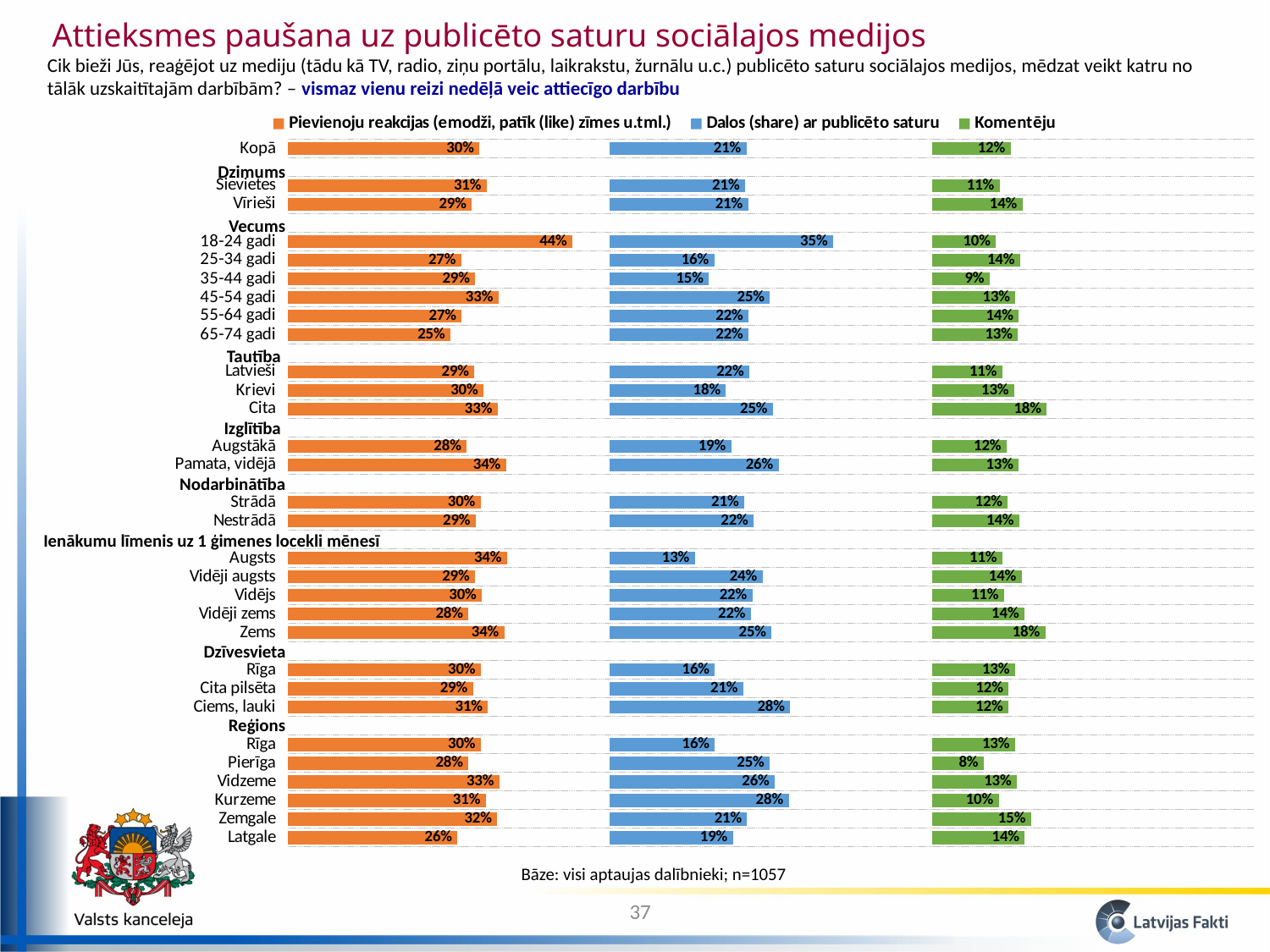
How many series does the legend list? 3 Which category has the lowest value for "Komentēju"? Pierīga Which has the larger "Pievienoju reakcijas" value, Vidzeme or Latgale? Vidzeme What kind of chart is shown on the slide? bar chart How many age groups (Vecums) are shown in the chart? 6 What is the value of "Pievienoju reakcijas" for Pamata, vidējā? 34% What is the value of "Dalos (share) ar publicēto saturu" for Kopā? 21% Which category has the lowest value for "Dalos (share) ar publicēto saturu"? Augsts What is the difference between the "Pievienoju reakcijas" value for 18-24 gadi and for Kopā? 14 percentage points What is the value of "Komentēju" for Pierīga? 8% Which category has the highest value for "Pievienoju reakcijas (emodži, patīk (like) zīmes u.tml.)"? 18-24 gadi Which series is shown in green in the chart? Komentēju